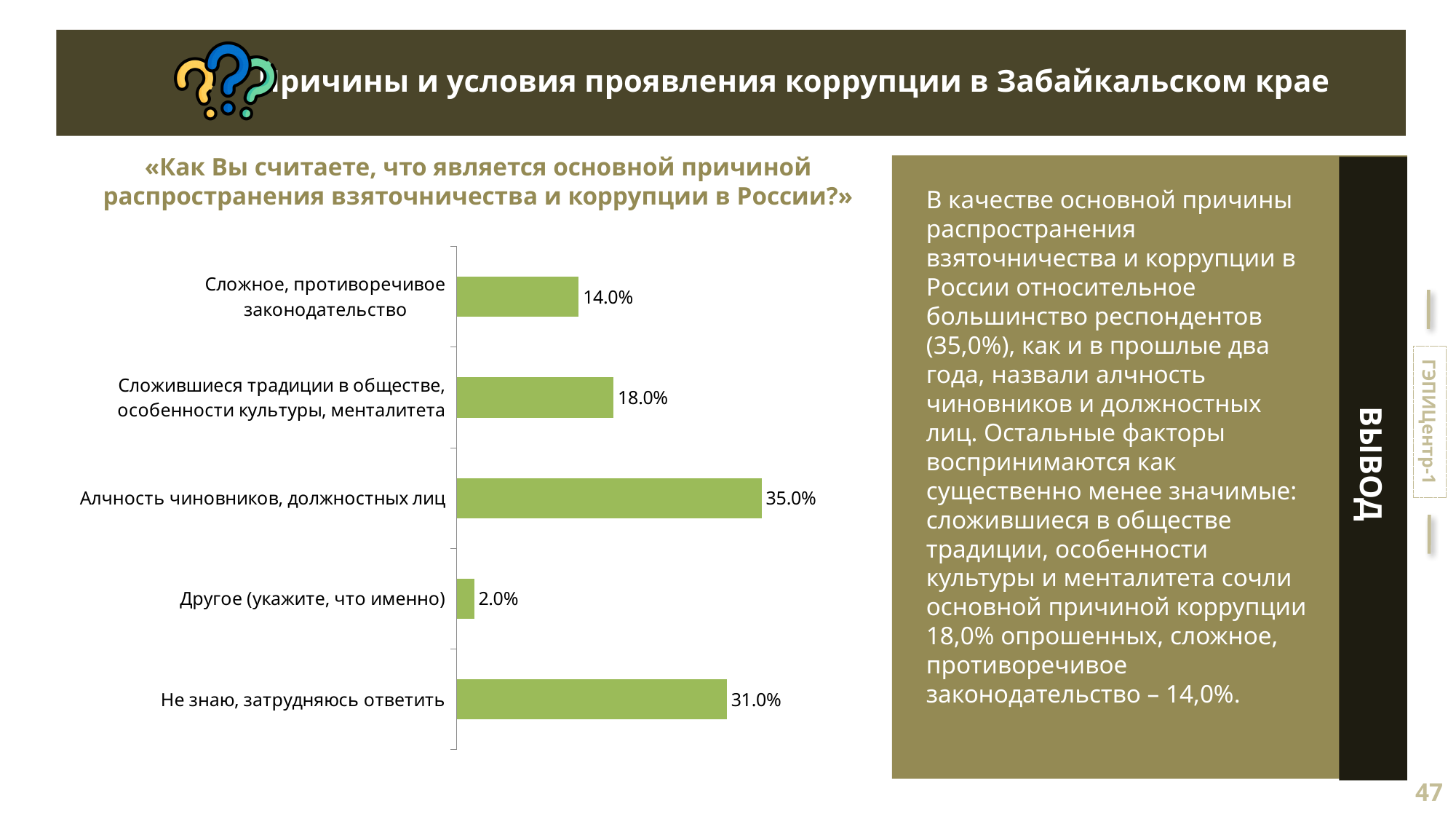
What kind of chart is shown on the slide? Bar chart How many categories are shown in the chart? 5 What value is shown for «Не знаю, затрудняюсь ответить»? 31.0% What is the difference between the values for «Алчность чиновников, должностных лиц» and «Не знаю, затрудняюсь ответить»? 4.0% What value is shown for «Другое (укажите, что именно)»? 2.0% What value is shown for «Алчность чиновников, должностных лиц»? 35.0% What value is shown for «Сложное, противоречивое законодательство»? 14.0% Which is larger: the value for «Сложившиеся традиции в обществе, особенности культуры, менталитета» or for «Сложное, противоречивое законодательство»? Сложившиеся традиции в обществе, особенности культуры, менталитета What question is the chart titled with? «Как Вы считаете, что является основной причиной распространения взяточничества и коррупции в России?» Which category has the highest value? Алчность чиновников, должностных лиц Which category has the lowest value? Другое (укажите, что именно) What is the difference between the values for «Сложившиеся традиции в обществе, особенности культуры, менталитета» and «Сложное, противоречивое законодательство»? 4.0%